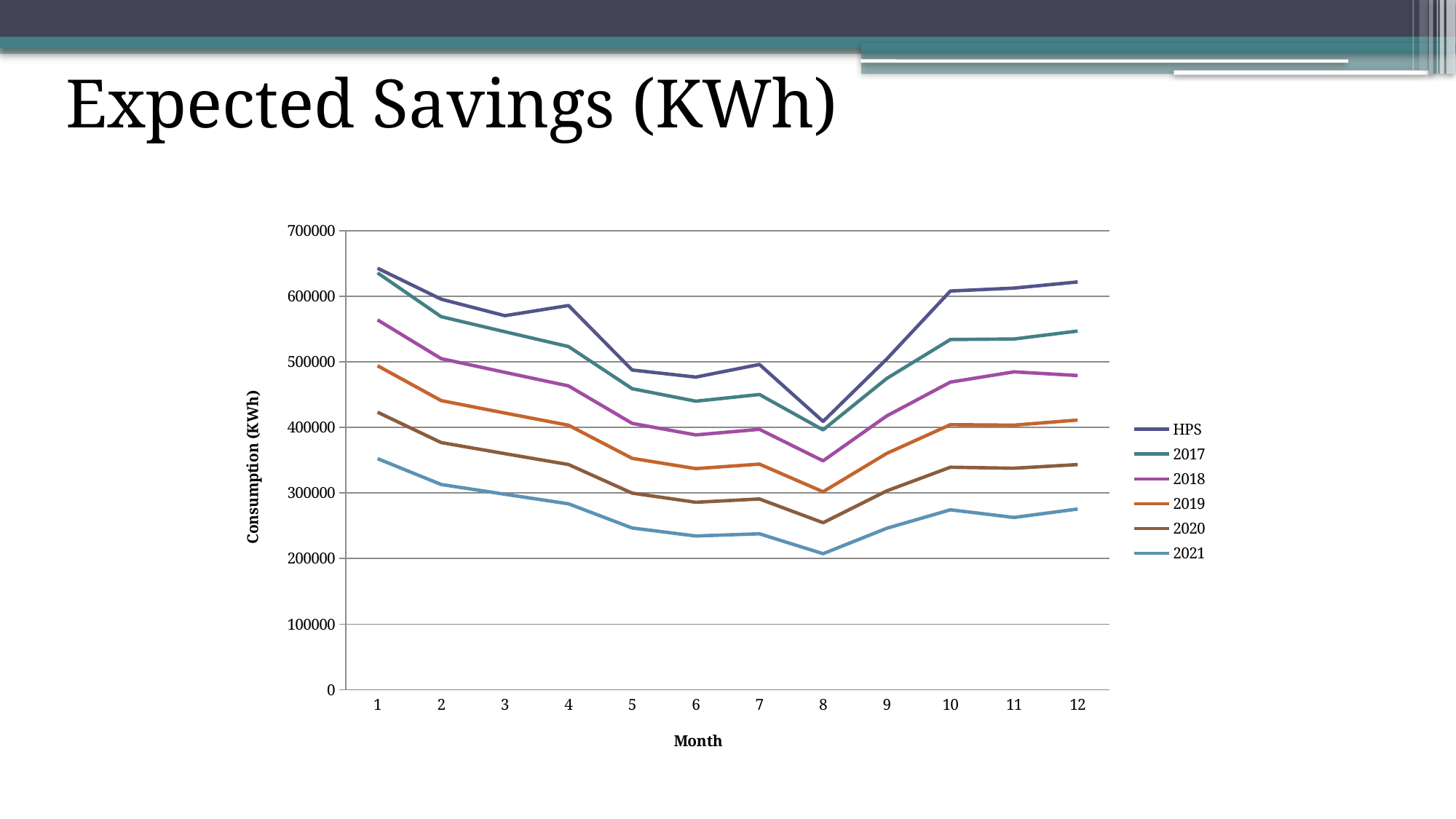
Does the 2021 series rise or fall from month 1 to month 8? fall How many months are plotted along the x axis? 12 What is the title of the y axis? Consumption (KWh) In which month does the 2021 series reach its lowest value? 8 Is the value for 2020 in month 8 greater or less than 300000? less What kind of chart is shown on the slide? line chart Is the value for HPS in month 1 greater or less than 600000? greater In which month does the 2021 series reach its highest value? 1 Is the value for 2021 in month 1 greater or less than 300000? greater How many series does the legend list? 6 In month 10, which is larger, HPS or 2017? HPS